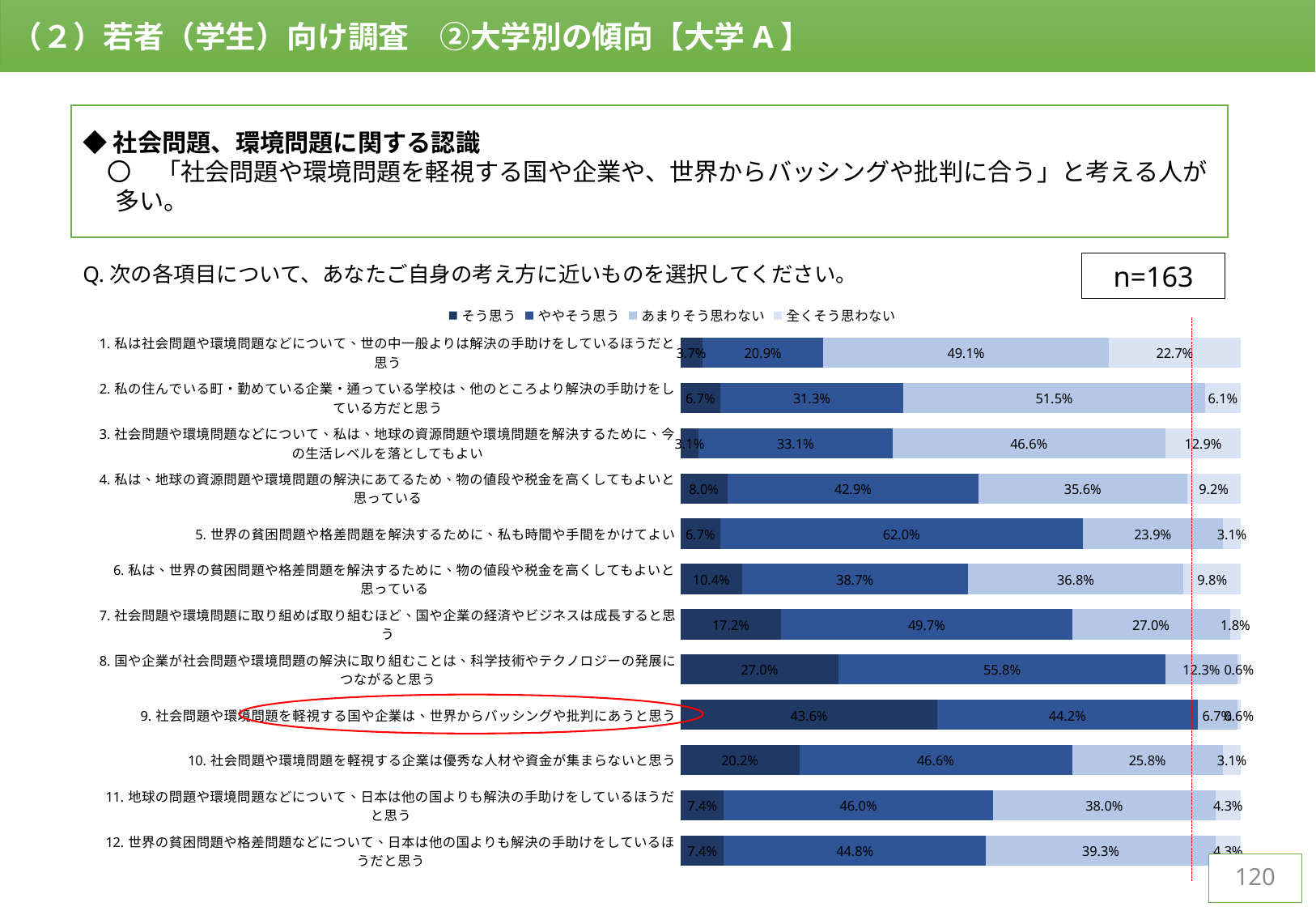
What is the sample size (n) shown on the slide? n=163 What is the 「そう思う」 value for item 9 (社会問題や環境問題を軽視する国や企業は、世界からバッシングや批判にあうと思う)? 43.6% What is the difference between the 「ややそう思う」 values of item 5 and item 1? 41.1% Which is larger: the 「全くそう思わない」 value for item 1 or for item 3? Item 1 (22.7%) What is the combined share of 「そう思う」 and 「ややそう思う」 for item 8 (国や企業が社会問題や環境問題の解決に取り組むことは、科学技術やテクノロジーの発展につながると思う)? 82.8% What kind of chart is shown on the slide? Stacked bar chart How many series does the legend list? 4 Which item has the lowest 「そう思う」 value? 3. 社会問題や環境問題などについて、私は、地球の資源問題や環境問題を解決するために、今の生活レベルを落としてもよい Which item has the highest 「そう思う」 value? 9. 社会問題や環境問題を軽視する国や企業は、世界からバッシングや批判にあうと思う What is the 「あまりそう思わない」 value for item 2 (私の住んでいる町・勤めている企業・通っている学校は、他のところより解決の手助けをしている方だと思う)? 51.5% What is the 「ややそう思う」 value for item 5 (世界の貧困問題や格差問題を解決するために、私も時間や手間をかけてよい)? 62.0% How many items (categories) are plotted in the chart? 12